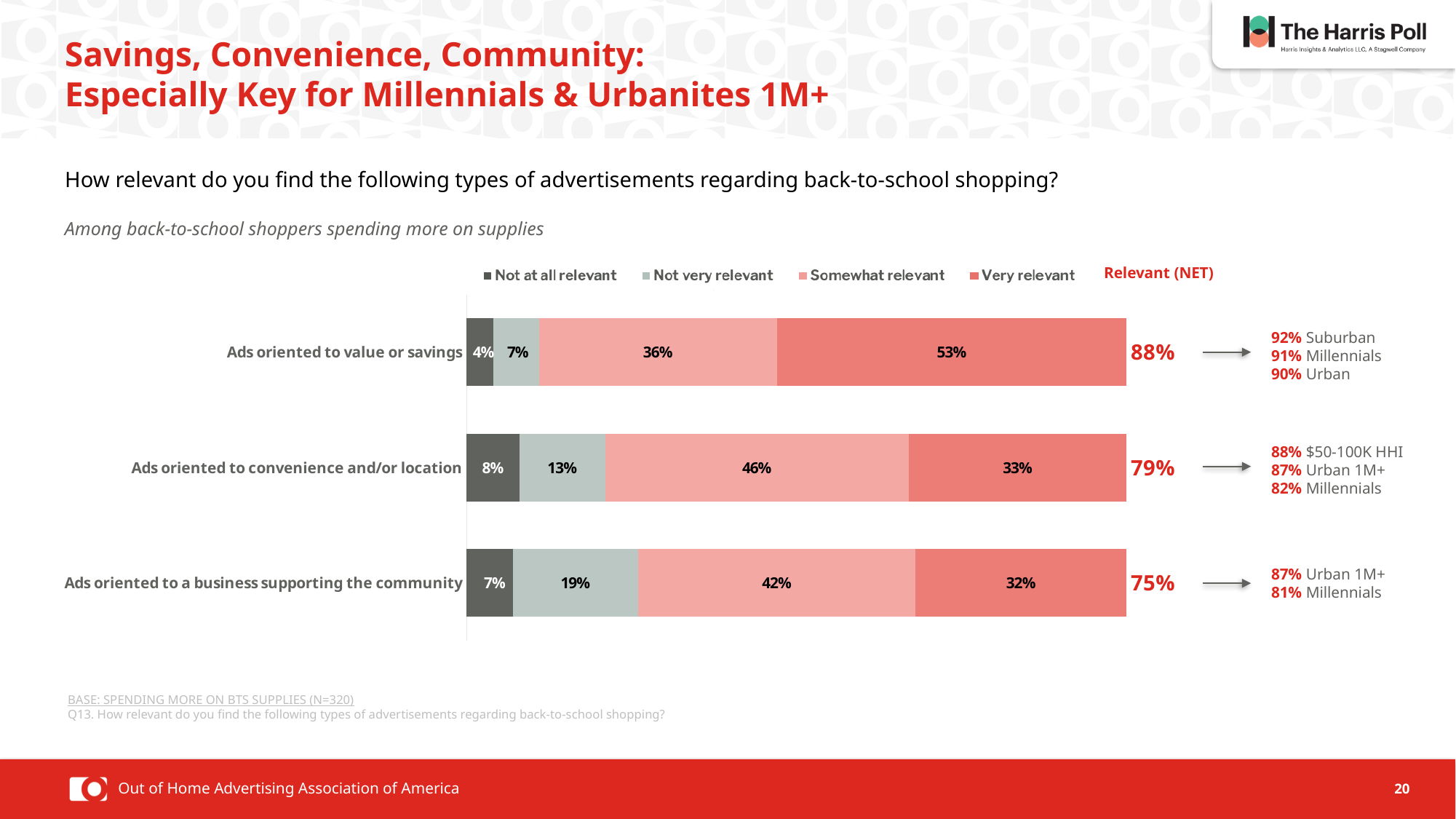
What is the Relevant (NET) value for ads oriented to convenience and/or location? 79% What kind of chart is shown on the slide? Stacked bar chart What percentage of respondents found ads oriented to value or savings very relevant? 53% What percentage of respondents found ads oriented to convenience and/or location somewhat relevant? 46% Which type of advertisement has the highest 'Very relevant' percentage? Ads oriented to value or savings How many series does the legend list? 4 What is the combined 'Somewhat relevant' and 'Very relevant' total for ads oriented to a business supporting the community? 74% What percentage of respondents found ads oriented to a business supporting the community not very relevant? 19% How many types of advertisements are shown in the chart? 3 What is the difference between the 'Very relevant' percentages for ads oriented to value or savings and ads oriented to a business supporting the community? 21 percentage points Which type of advertisement has the lowest 'Not at all relevant' percentage? Ads oriented to value or savings Which is larger: the 'Not very relevant' share for ads oriented to convenience and/or location or for ads oriented to a business supporting the community? Ads oriented to a business supporting the community